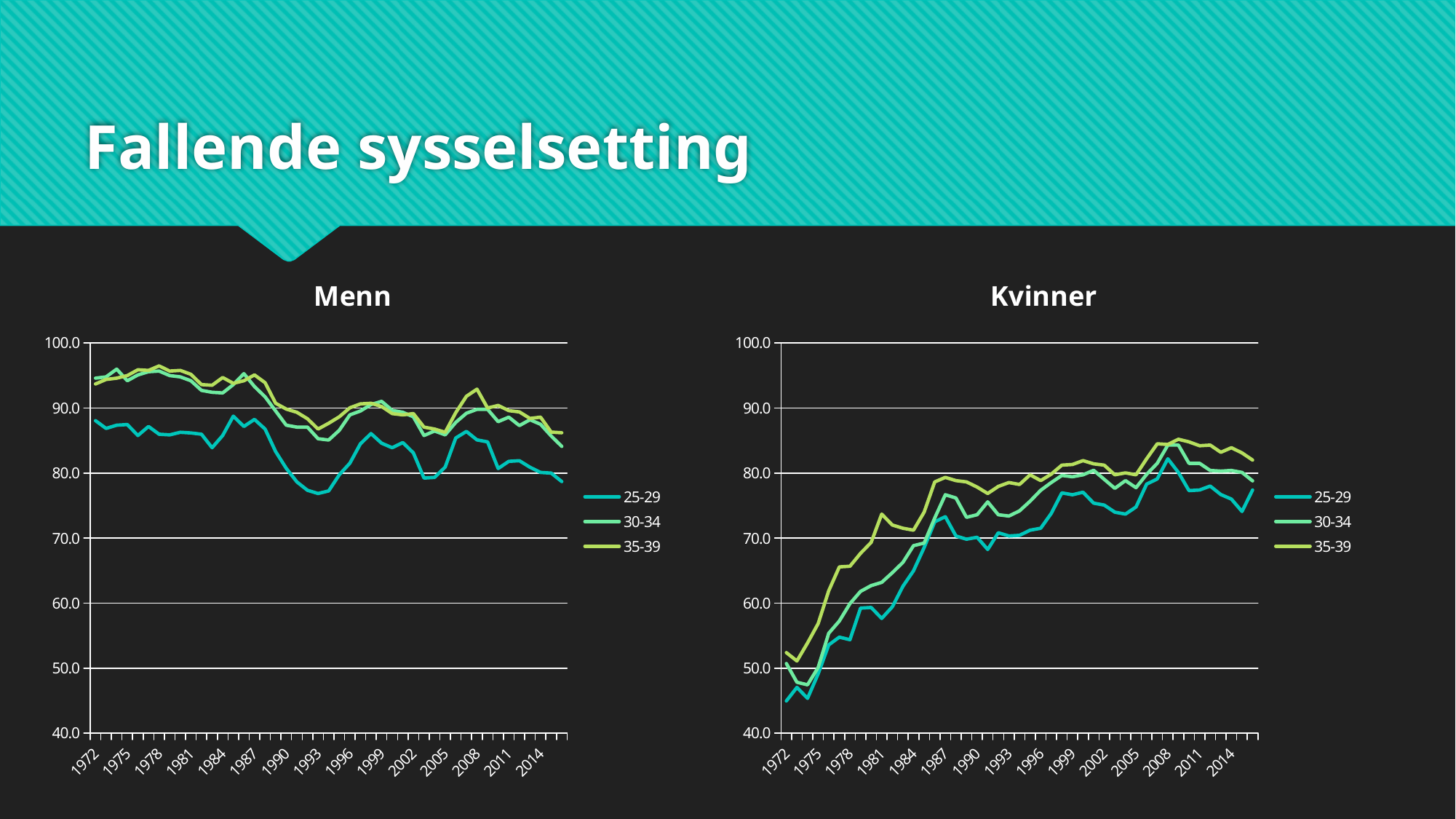
In the Kvinner chart, does the 35-39 series rise or fall overall from 1972 to the end of the period? rise How many year labels are shown on the x axis of the Menn chart? 15 What is the title of the chart on the right side of the slide? Kvinner What kind of chart is the Menn chart? line chart In the Kvinner chart, is the value for the 25-29 series in 1972 greater or less than 50? less In the Menn chart, is the value for the 25-29 series in 1993 greater or less than 80? less In the Kvinner chart, which series has the higher value in 1978, 25-29 or 35-39? 35-39 In the Menn chart, does the 25-29 series rise or fall overall from 1972 to the end of the period? fall In the Kvinner chart, is the value for the 35-39 series in 2008 greater or less than 80? greater How many series does the legend of the Kvinner chart list? 3 In the Menn chart, which series has the higher value in 1972, 25-29 or 35-39? 35-39